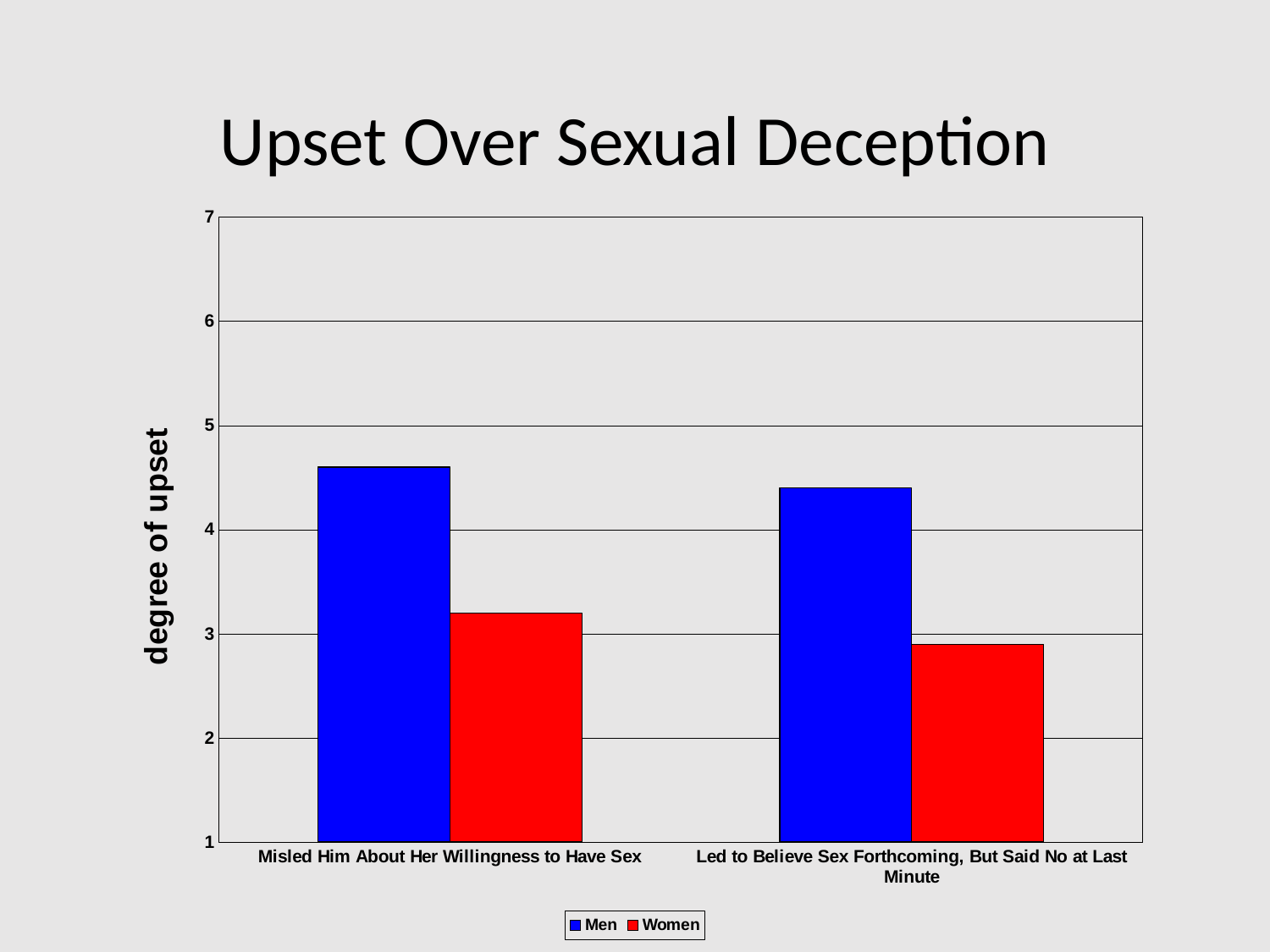
Is the value for Men in the 'Misled Him About Her Willingness to Have Sex' category greater or less than 5? less What type of chart is shown on the slide? bar chart Is the value for Men in the 'Misled Him About Her Willingness to Have Sex' category greater or less than 4? greater Is the value for Men in the 'Led to Believe Sex Forthcoming, But Said No at Last Minute' category greater or less than 4? greater How many categories are shown on the x axis? 2 In the 'Misled Him About Her Willingness to Have Sex' category, which is larger, the value for Men or for Women? Men How many series does the legend list? 2 What is the label of the vertical axis? degree of upset What is the title of the chart? Upset Over Sexual Deception In the 'Led to Believe Sex Forthcoming, But Said No at Last Minute' category, which is larger, the value for Men or for Women? Men